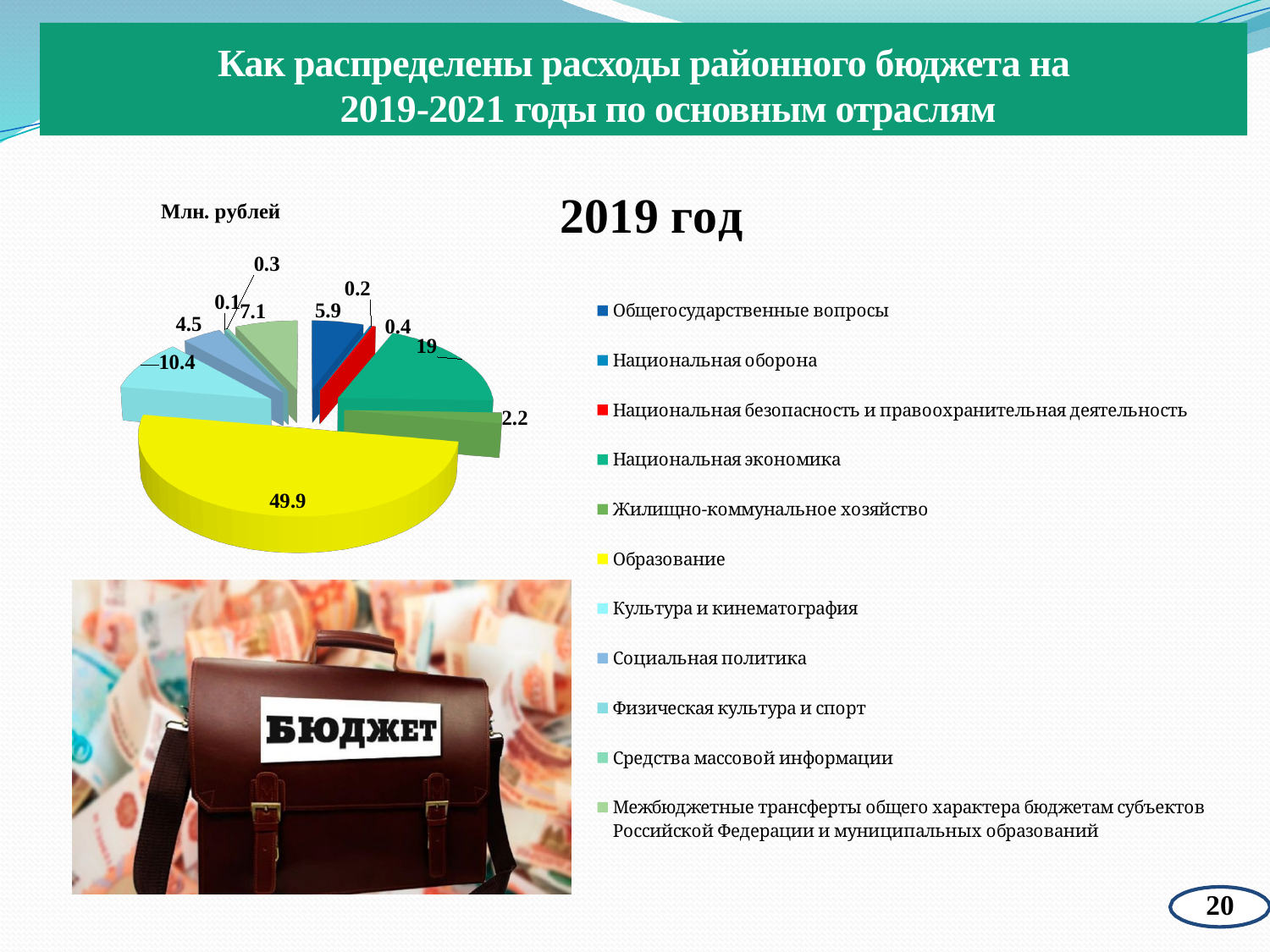
What is the value for Национальная экономика in the pie chart? 19 Which category has the largest slice in the pie chart? Образование Which year does the pie chart refer to, according to the heading next to it? 2019 год Which is larger: the value for Национальная экономика or the value for Культура и кинематография? Национальная экономика What unit label is shown above the pie chart? Млн. рублей What is the difference between the values for Образование and Национальная экономика? 30.9 What is the value for Жилищно-коммунальное хозяйство in the pie chart? 2.2 What is the value for Культура и кинематография in the pie chart? 10.4 What type of chart is shown on the slide? Pie chart How many categories does the legend of the pie chart list? 11 What is the value for Общегосударственные вопросы in the pie chart? 5.9 What is the value for Образование in the pie chart? 49.9